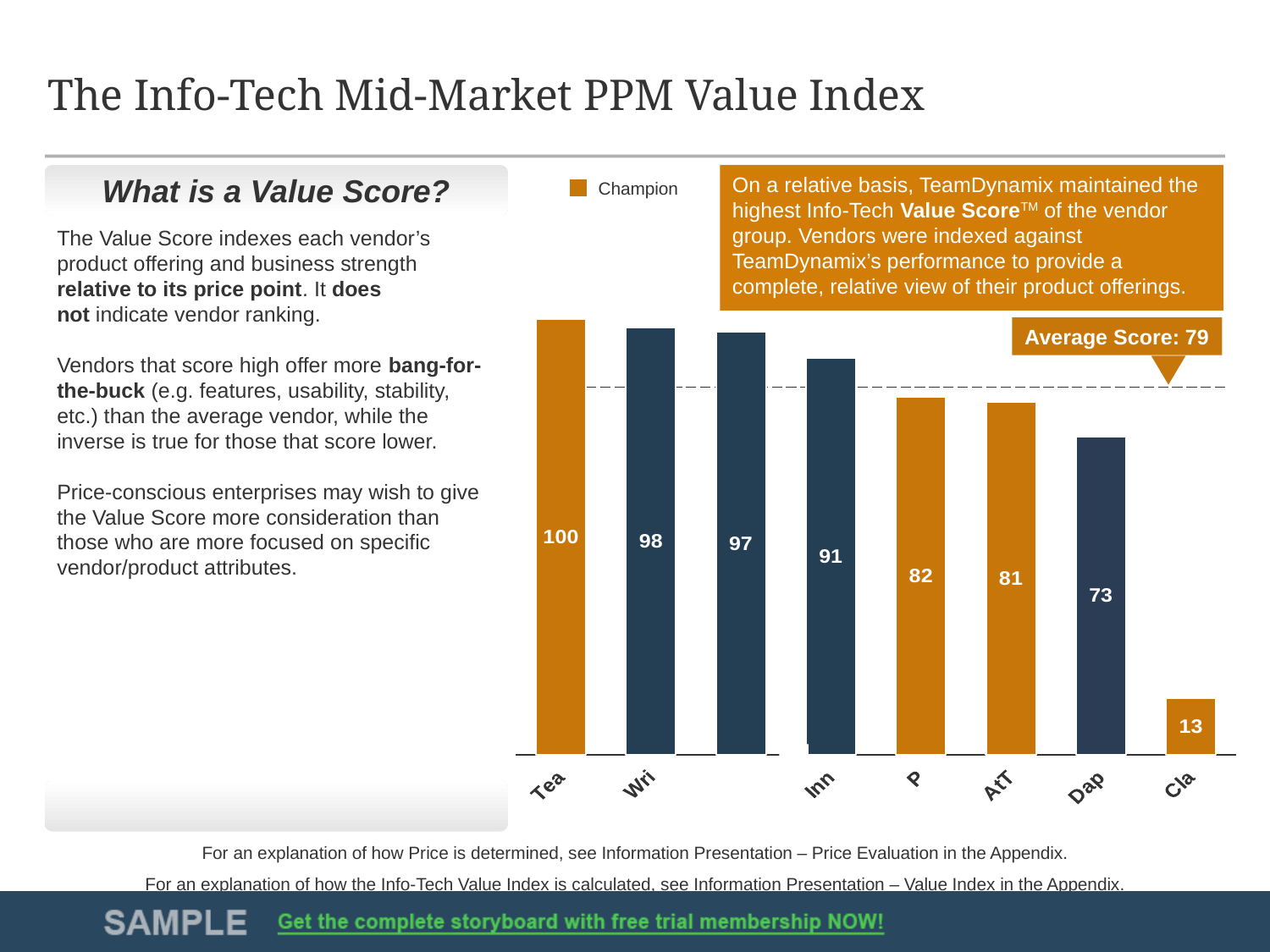
Do the bar values rise or fall from left to right across the chart? fall What is the value shown for the bar labelled "Inn"? 91 What is the value shown for the bar labelled "Dap"? 73 What kind of chart is shown on the slide? bar chart What Average Score is called out on the chart? 79 How many bars are plotted in the chart? 8 How many entries does the chart legend list? 1 Which bar has the highest value in the chart? Tea (the first bar), 100 Which is larger, the value for "Wri" or the value for "AtT"? Wri (98) Which bar has the lowest value in the chart? Cla (the last bar), 13 How many bars have values above the Average Score of 79 line? 6 What is the difference between the highest bar (100) and the lowest bar (13)? 87